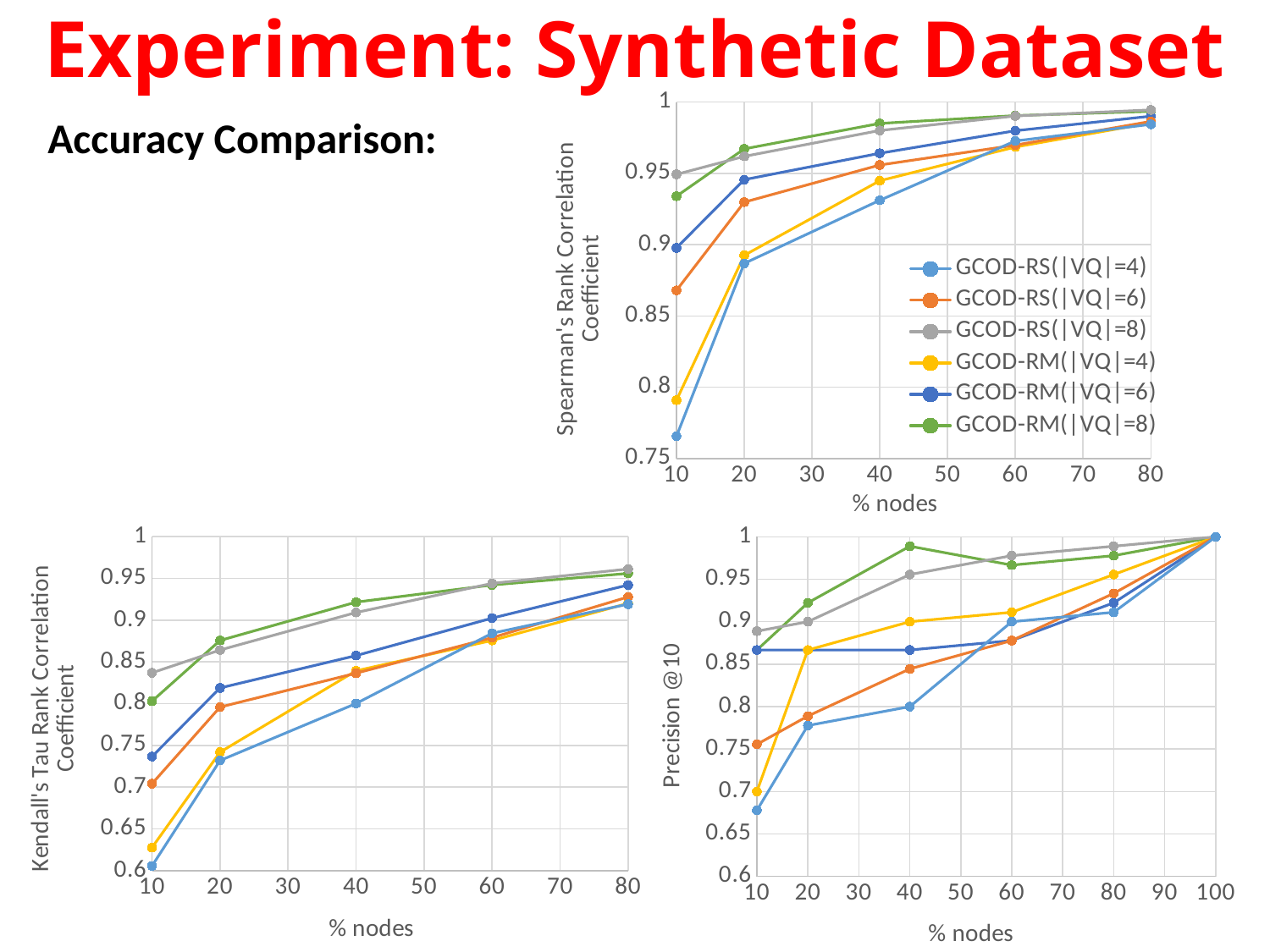
In the Kendall's Tau Rank Correlation Coefficient chart, does the GCOD-RS(|VQ|=4) series rise or fall as % nodes increases? rise In the Precision @10 chart, how many data points does each series have? 6 In the Precision @10 chart, what value do all series reach at 100% nodes? 1 In the Spearman's Rank Correlation Coefficient chart, which series has the lowest value at 10% nodes? GCOD-RS(|VQ|=4) What kind of chart is the Spearman's Rank Correlation Coefficient chart? line chart In the Precision @10 chart, is the value for GCOD-RM(|VQ|=8) at 40% nodes greater or less than 0.95? greater In the Kendall's Tau Rank Correlation Coefficient chart, is the value for GCOD-RS(|VQ|=4) at 10% nodes greater or less than 0.65? less How many series does the legend on the Spearman's Rank Correlation Coefficient chart list? 6 In the Spearman's Rank Correlation Coefficient chart, how many data points does each series have? 5 In the Precision @10 chart, which is larger at 40% nodes: GCOD-RM(|VQ|=8) or GCOD-RS(|VQ|=4)? GCOD-RM(|VQ|=8) In the Kendall's Tau Rank Correlation Coefficient chart, which series has the highest value at 10% nodes? GCOD-RS(|VQ|=8) In the Spearman's Rank Correlation Coefficient chart, is the value for GCOD-RS(|VQ|=4) at 10% nodes greater or less than 0.8? less